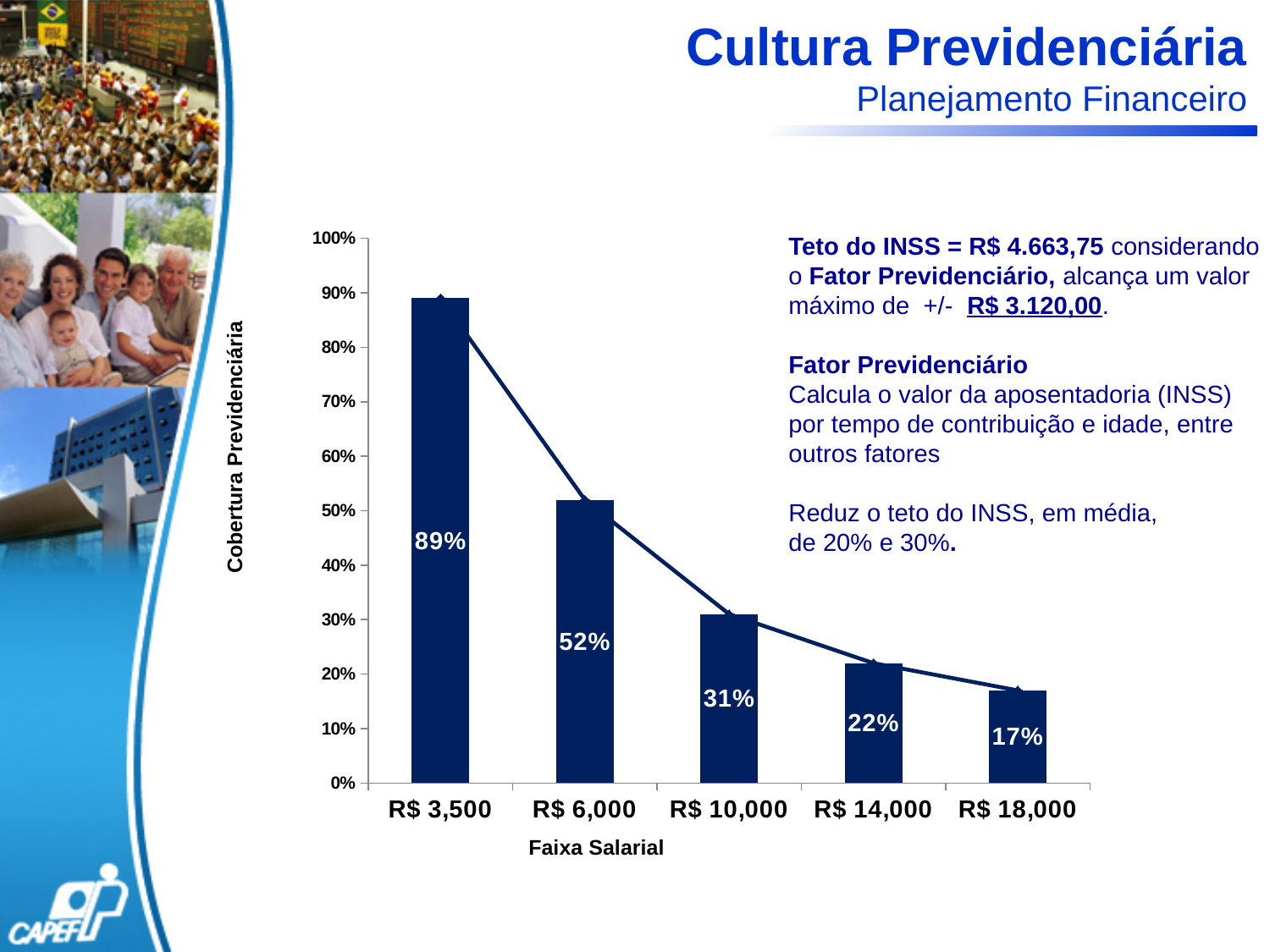
What is the Cobertura Previdenciária value for the R$ 3,500 salary range? 89% How many salary ranges are shown on the x axis of the chart? 5 What is the difference between the Cobertura Previdenciária for R$ 3,500 and for R$ 6,000? 37% What is the Cobertura Previdenciária value for the R$ 10,000 salary range? 31% What is the Cobertura Previdenciária value for the R$ 18,000 salary range? 17% What kind of chart is shown on the slide? Bar chart with a line overlay Which salary range has the lowest Cobertura Previdenciária? R$ 18,000 Which salary range has the highest Cobertura Previdenciária? R$ 3,500 Which has a higher Cobertura Previdenciária, R$ 6,000 or R$ 10,000? R$ 6,000 Do the Cobertura Previdenciária values rise or fall as the salary range increases along the x axis? Fall What is the label of the x axis of the chart? Faixa Salarial What is the difference between the Cobertura Previdenciária for R$ 14,000 and for R$ 18,000? 5%